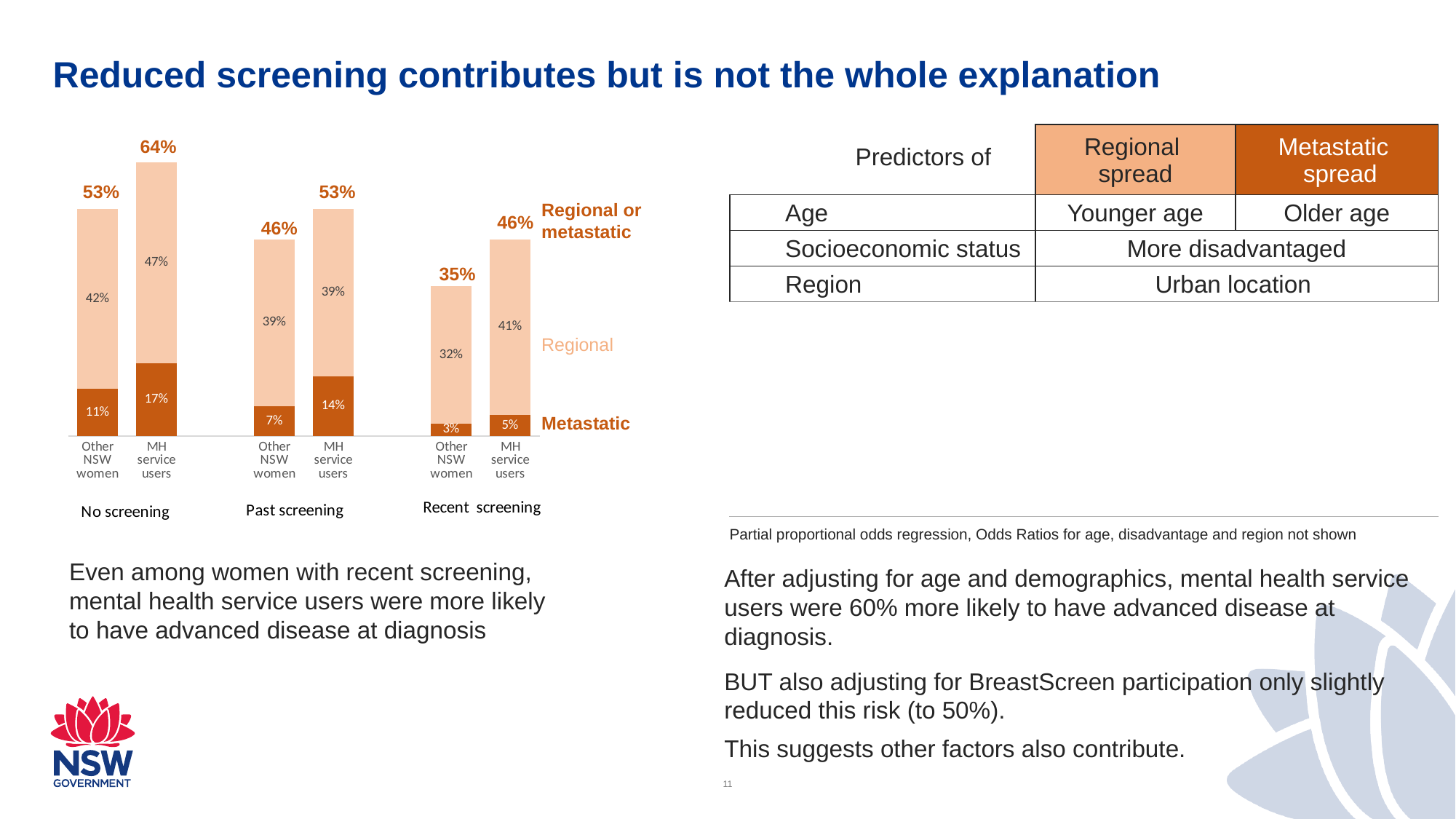
Which bar has the lowest total Regional or metastatic value? Other NSW women, Recent screening (35%) How do the total values for MH service users change from No screening to Past screening to Recent screening? They fall (64%, 53%, 46%) Which bar has the highest total Regional or metastatic value? MH service users, No screening (64%) How many bars are plotted in the chart? 6 What is the Regional value for Other NSW women in the Recent screening group? 32% Which is larger: the Metastatic value for Other NSW women with Past screening or for MH service users with Past screening? MH service users (14%) Which segment of each bar is shown in the darker orange colour? Metastatic What is the Metastatic value for Other NSW women in the Recent screening group? 3% What is the Metastatic value for MH service users in the No screening group? 17% What is the total Regional or metastatic value for MH service users in the Past screening group? 53% What type of chart is shown on the slide? Stacked bar chart What is the difference between the total values for MH service users and Other NSW women in the Recent screening group? 11 percentage points